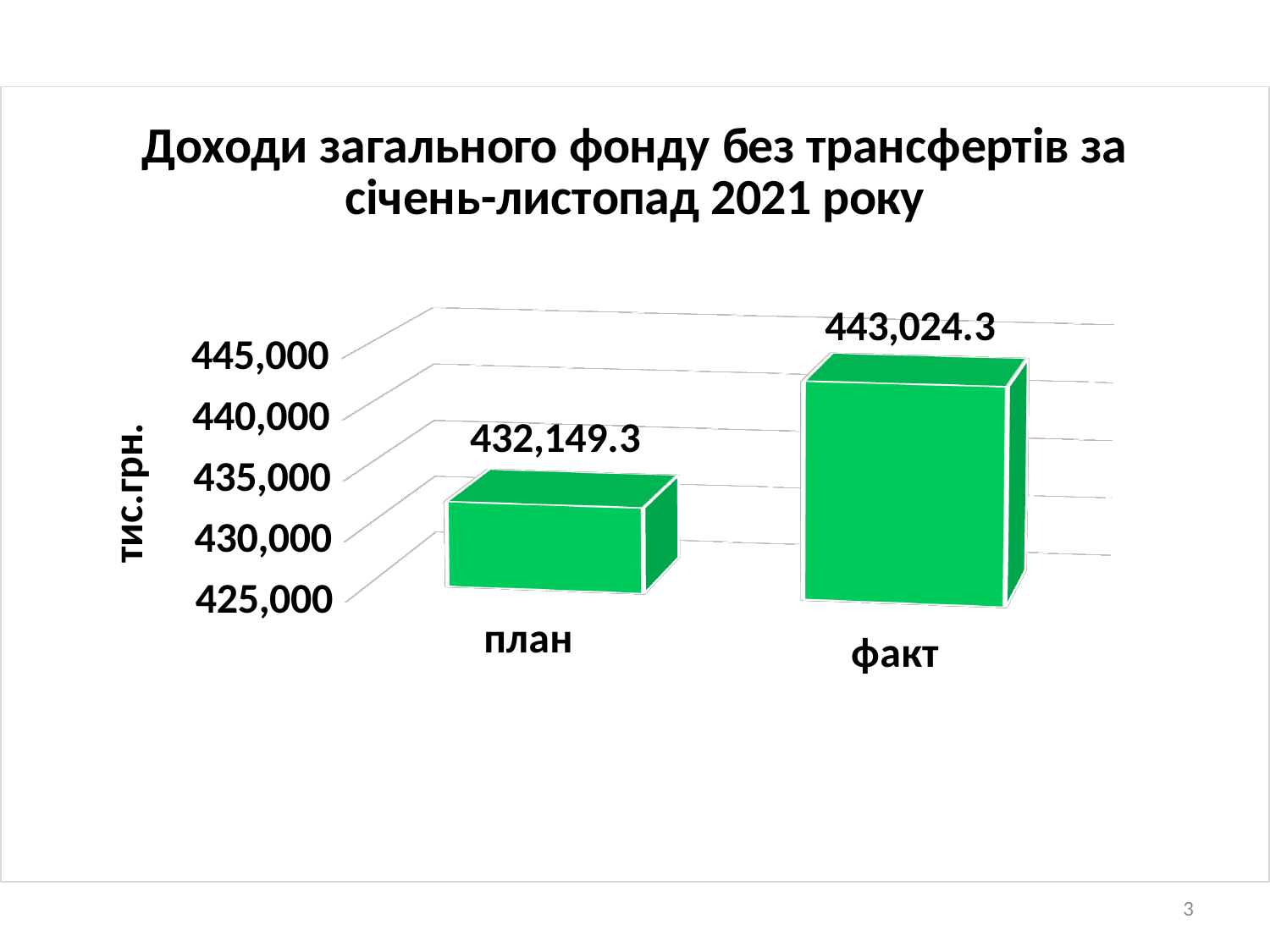
What is the difference between the values for факт and план? 10,875.0 What kind of chart is shown on the slide? bar chart Is the value for факт greater or less than 440,000? greater Which category has the highest value? факт What is the value for план? 432,149.3 How many categories are shown in the chart? 2 What is the label of the vertical axis? тис.грн. Is the value for план greater or less than 430,000? greater What is the value for факт? 443,024.3 What is the title of the chart? Доходи загального фонду без трансфертів за січень-листопад 2021 року Which is larger, the value for план or the value for факт? факт Which category has the lowest value? план